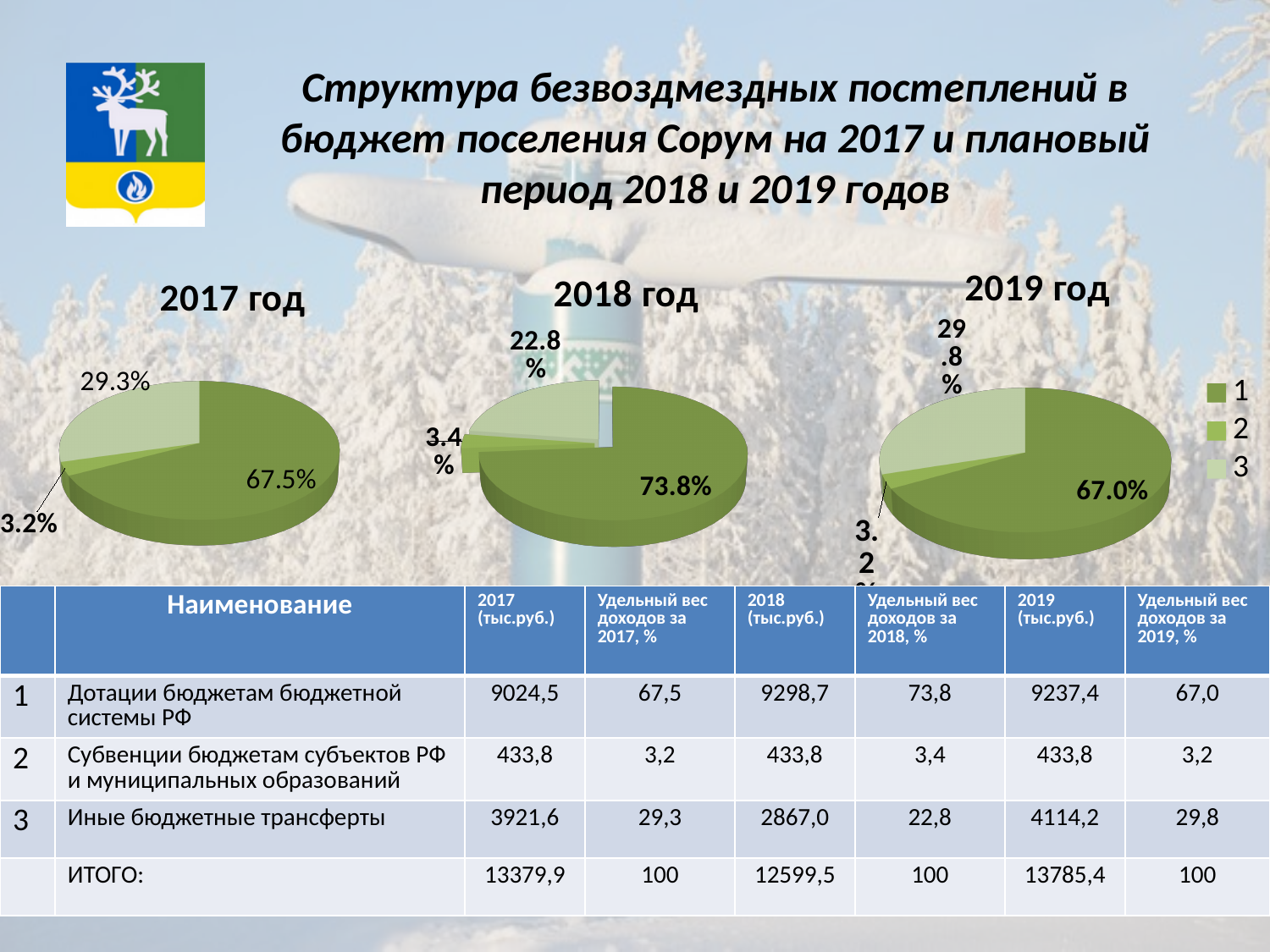
How many entries does the legend next to the "2019 год" chart list? 3 In the "2017 год" pie chart, what is the value of the smallest slice? 3.2% In the "2018 год" pie chart, what is the value of the smallest slice? 3.4% In the "2018 год" pie chart, what is the value of the light green slice (series 3)? 22.8% What kind of chart is the "2017 год" chart? pie chart How many slices does each pie chart have? 3 Which is larger: the light green slice in the "2017 год" chart or the light green slice in the "2018 год" chart? 2017 год (29.3%) What is the difference between the largest slice in the "2018 год" chart and the largest slice in the "2017 год" chart? 6.3% In the "2019 год" pie chart, what is the value of the light green slice (series 3)? 29.8% In the "2017 год" pie chart, what is the value of the largest slice? 67.5% In the "2018 год" pie chart, what is the value of the largest slice? 73.8% In the "2019 год" pie chart, what is the value of the largest slice? 67.0%